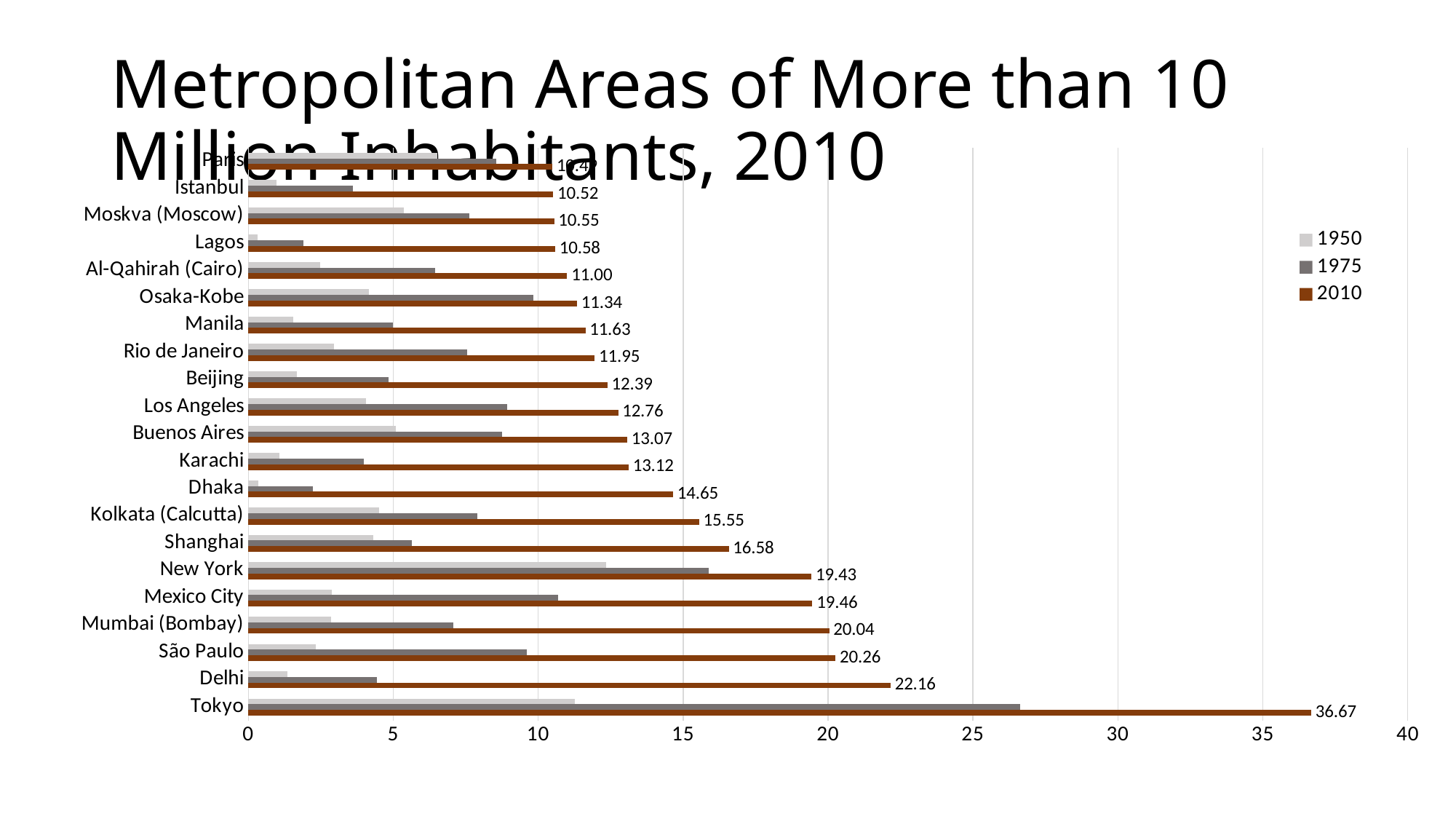
Which city has the highest 2010 value? Tokyo Is the 1975 value for Tokyo greater or less than 25? greater What is the difference between the 2010 values for Shanghai and Kolkata (Calcutta)? 1.03 How many series does the legend list? 3 What is the 2010 value for Dhaka? 14.65 What is the 2010 value for Lagos? 10.58 What kind of chart is shown on the slide? bar chart Is the 1950 value for New York greater or less than 10? greater Which has the larger 2010 value, Karachi or Dhaka? Dhaka What is the difference between the 2010 values for Tokyo and Delhi? 14.51 What is the 2010 value for Tokyo? 36.67 How many cities are shown on the chart? 21